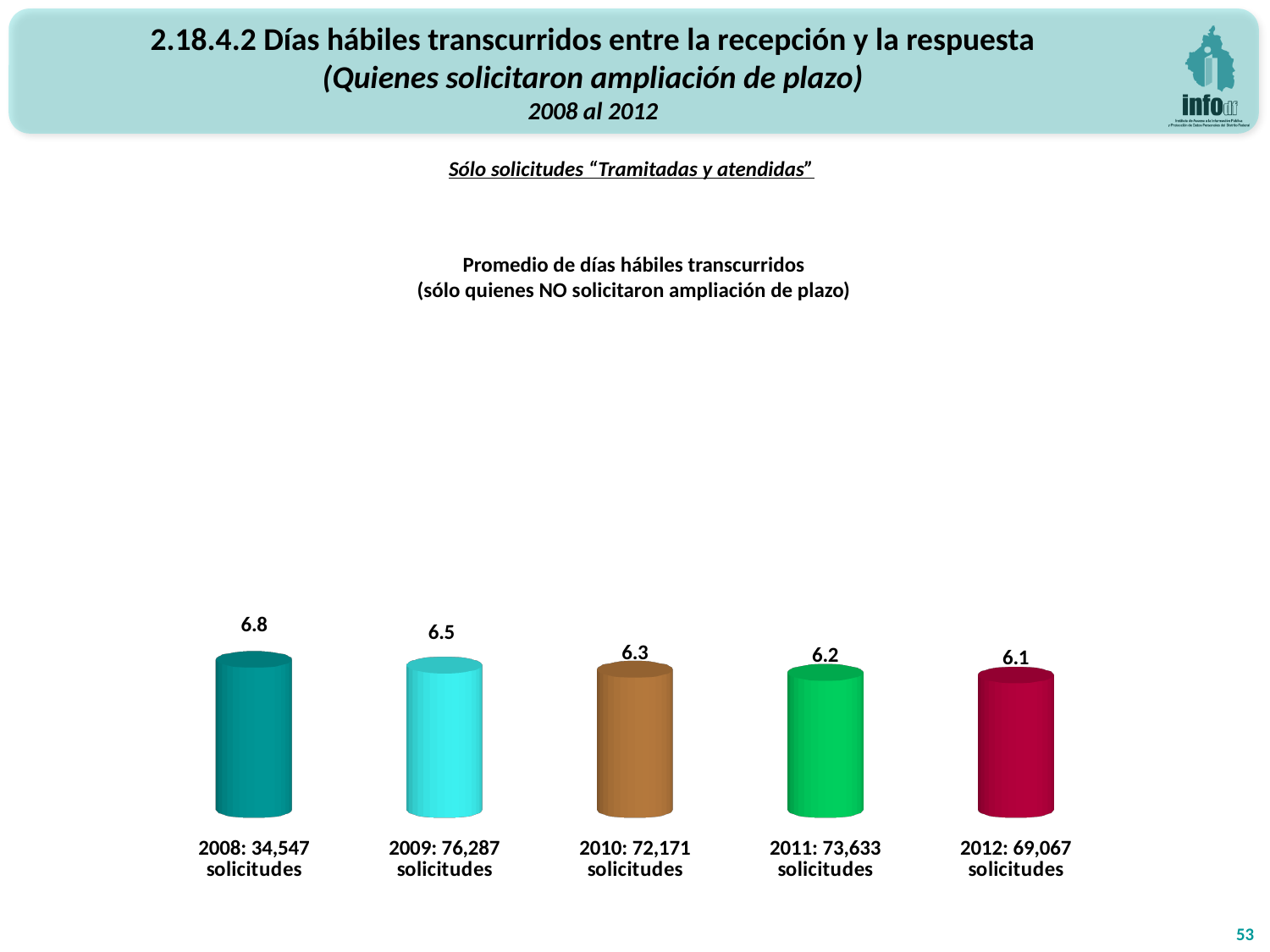
Which year has the lowest average number of business days? 2012 What is the average number of business days for 2008? 6.8 How many solicitudes are indicated for 2009 in the category label? 76,287 How many years are shown in the chart? 5 Do the values rise or fall from 2008 to 2012? fall What is the difference between the 2009 and 2011 values? 0.3 Which is larger, the value for 2009 or the value for 2011? 2009 What kind of chart is shown on the slide? bar chart What is the difference between the 2008 and 2012 values? 0.7 Which year has the highest average number of business days? 2008 What is the average number of business days for 2012? 6.1 What is the average number of business days for 2010? 6.3